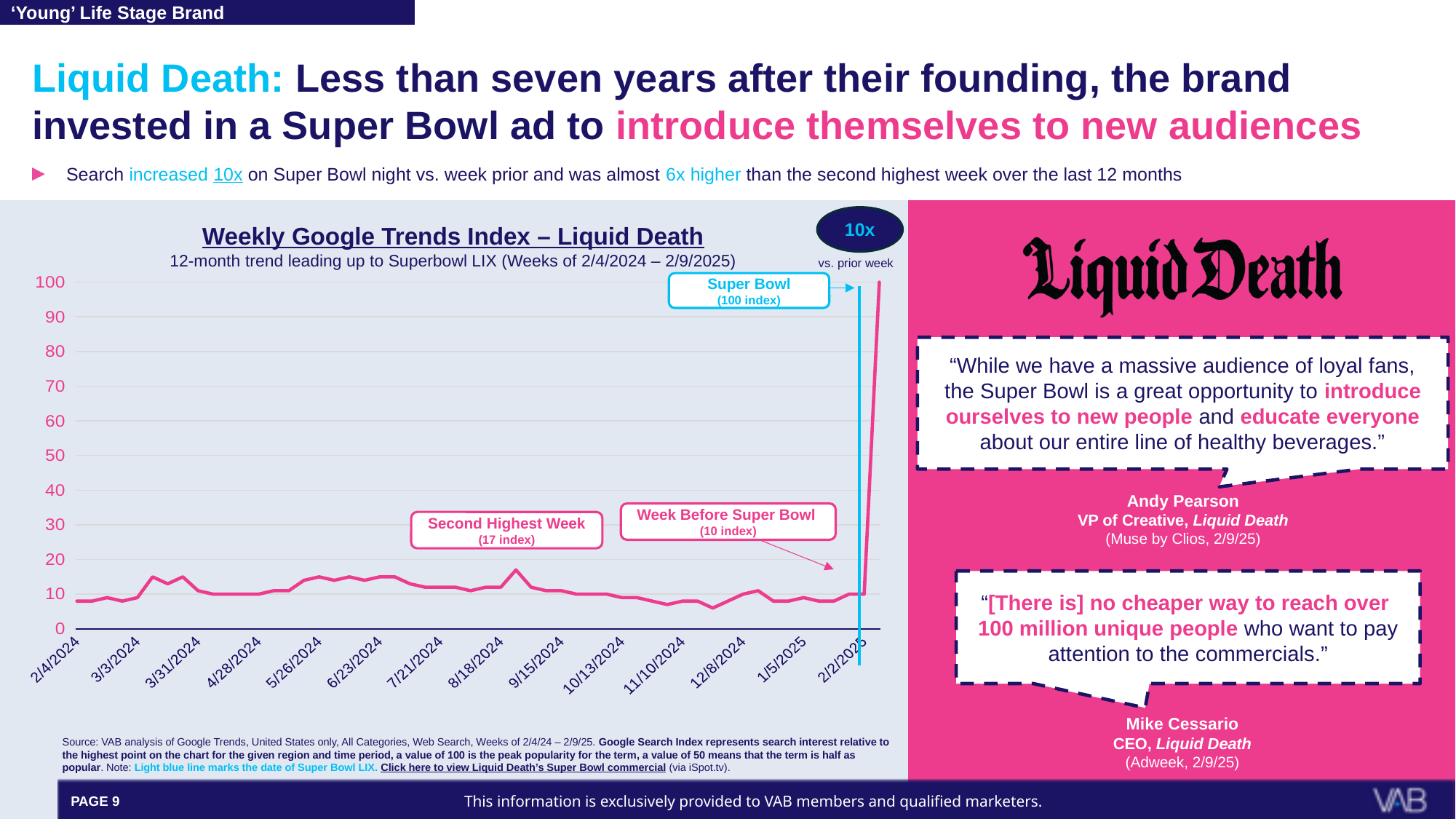
What is the index value for the Week Before Super Bowl? 10 What is the title of the chart? Weekly Google Trends Index – Liquid Death Over the final weeks of the series leading into 2/9/2025, does the index rise or fall? rise Which is larger, the Second Highest Week index or the Week Before Super Bowl index? Second Highest Week How many date labels are shown on the x axis? 14 By how much does the Super Bowl week index exceed the Week Before Super Bowl index? 90 What is the Google Trends index value for the Super Bowl week? 100 What kind of chart is shown on the slide? Line chart What is the index value for the Second Highest Week? 17 Is the index value for the week of 2/4/2024 greater or less than 20? less Which week has the highest index value on the chart? Super Bowl week (100 index) What is the difference between the Super Bowl week index and the Second Highest Week index? 83